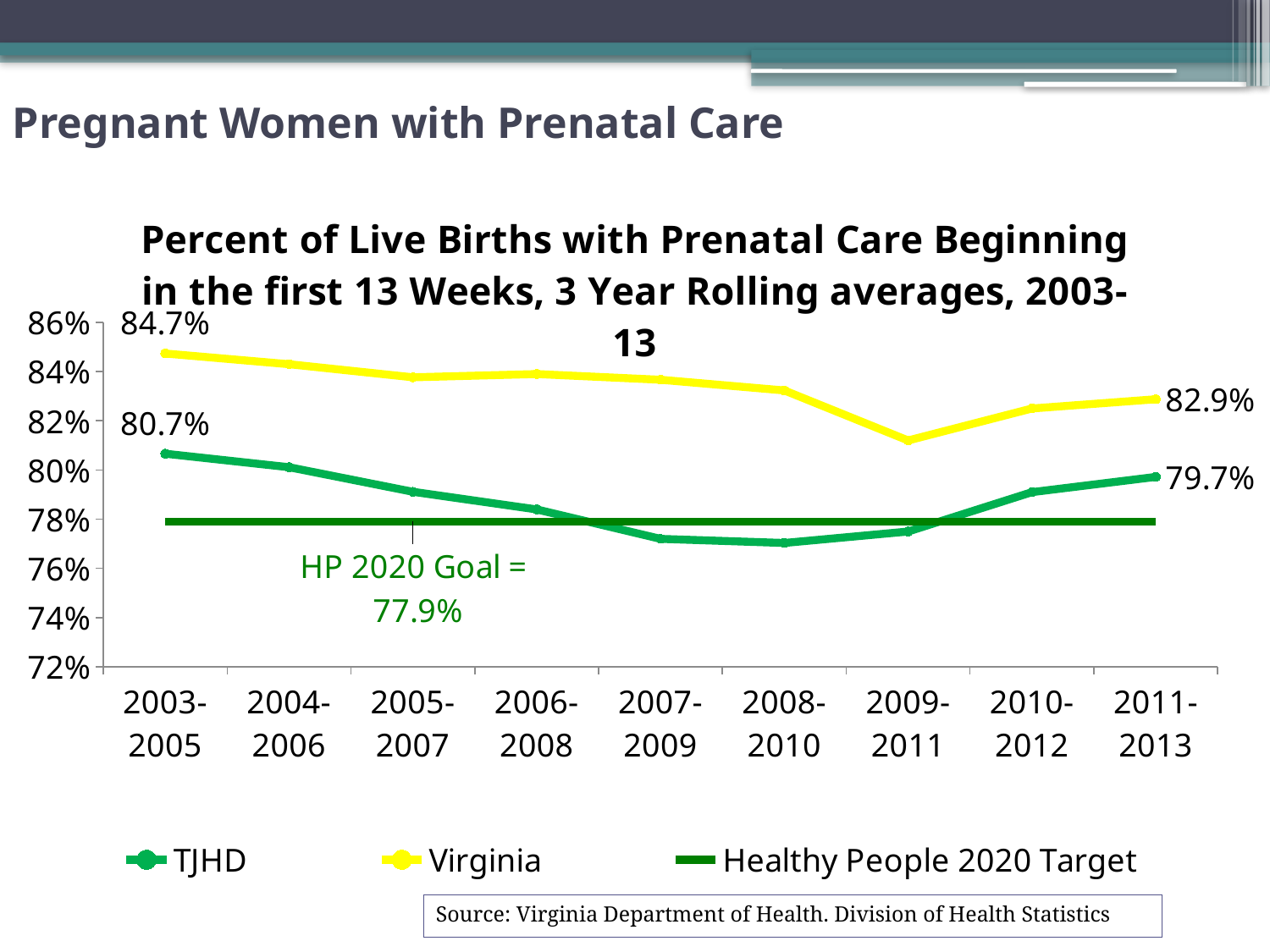
What is the Healthy People 2020 Target value? 77.9% How many series does the legend list? 3 What is the Virginia value for 2003-2005? 84.7% Which series is higher in 2009-2011, TJHD or Virginia? Virginia What is the TJHD value for 2003-2005? 80.7% How many time periods are shown on the x axis? 9 What is the Virginia value for 2011-2013? 82.9% What is the difference between the TJHD value for 2003-2005 and the TJHD value for 2011-2013? 1.0% What is the difference between the Virginia and TJHD values for 2003-2005? 4.0% Is the TJHD value for 2008-2010 greater or less than 78%? less What is the TJHD value for 2011-2013? 79.7% What type of chart is shown on the slide? line chart